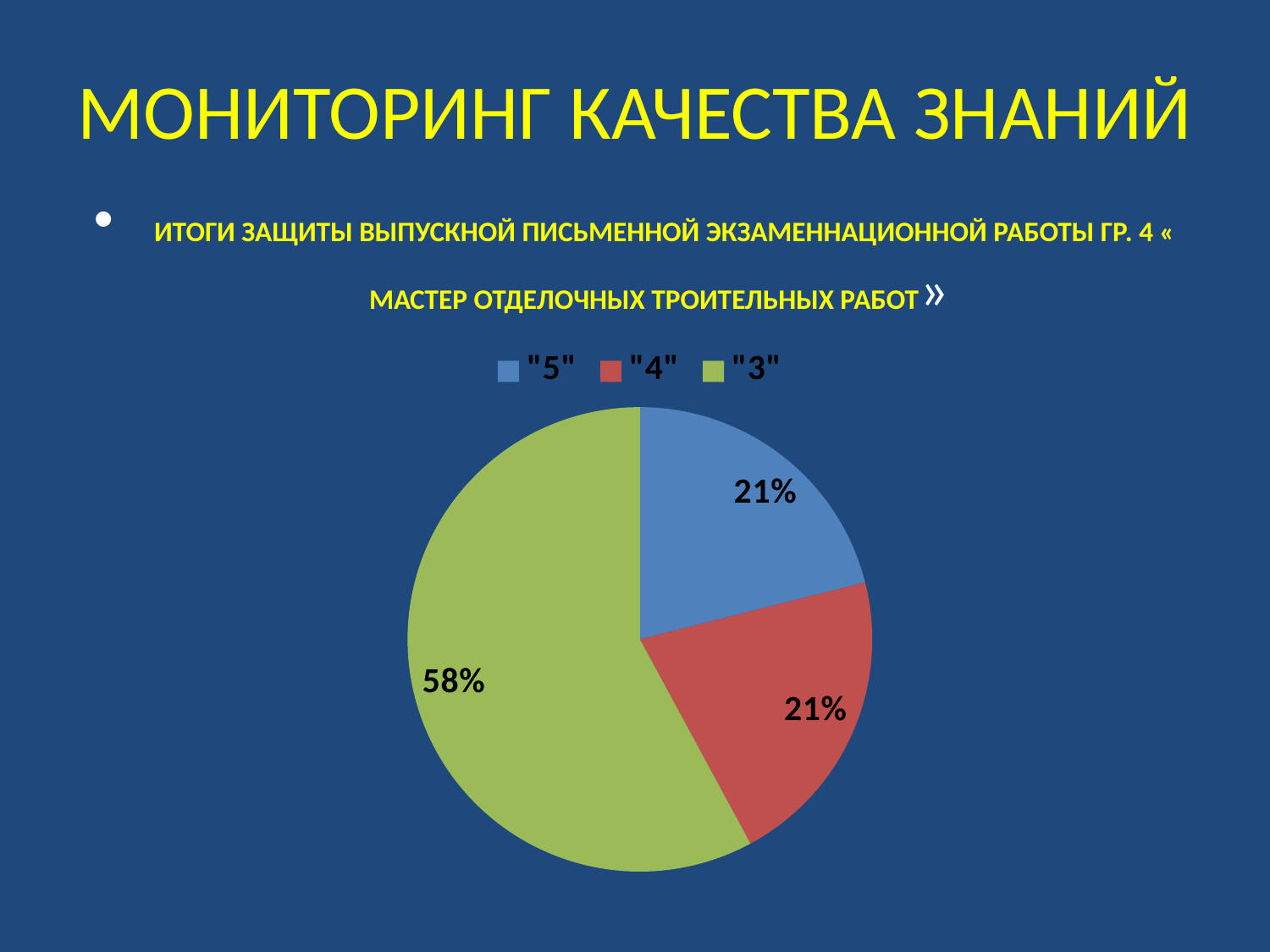
What colour is the slice for "5"? blue Is the share for "3" greater or less than 50%? greater What share of the pie does the "3" slice take? 58% Which grade has the largest slice of the pie? "3" How many entries does the legend list? 3 What share of the pie does the "5" slice take? 21% What share of the pie does the "4" slice take? 21% What kind of chart is shown on the slide? pie chart What is the difference between the share for "3" and the share for "4"? 37% What colour is the slice for "4"? red Is the share for "3" larger than the share for "5"? Yes How many slices does the pie chart have? 3